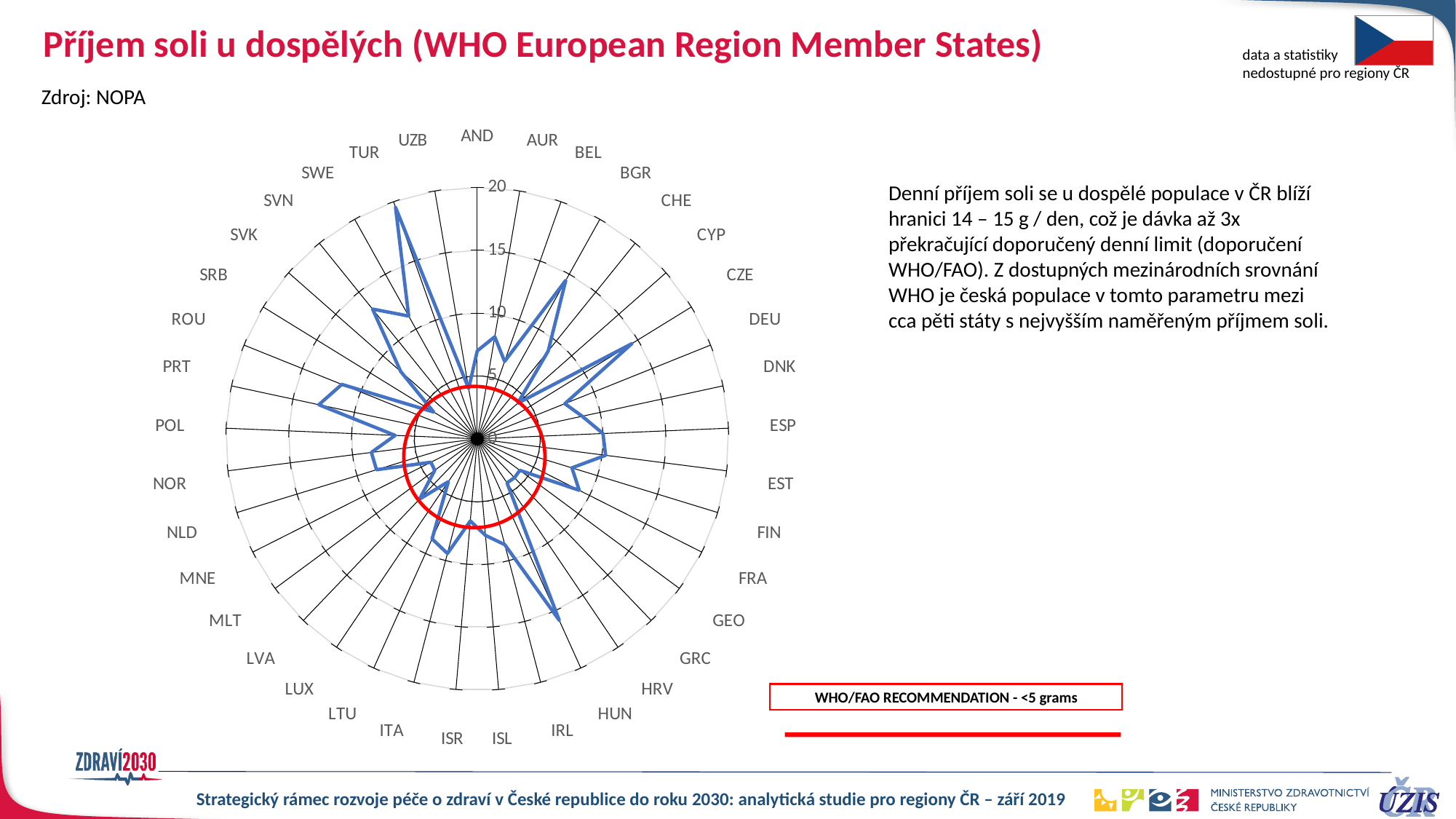
What kind of chart is shown on the slide? radar chart Is the value for BGR greater or less than 10? greater What is the title of the chart on the slide? Příjem soli u dospělých (WHO European Region Member States) Which has the larger value, TUR or CZE? TUR Which country has the highest salt intake value on the radar chart? TUR Is the value for CZE greater or less than 10? greater What is the highest tick value shown on the radial axis of the chart? 20 Is the value for TUR greater or less than 15? greater How many countries are plotted on the radar chart? 37 What does the red circle on the radar chart represent? WHO/FAO recommendation - <5 grams